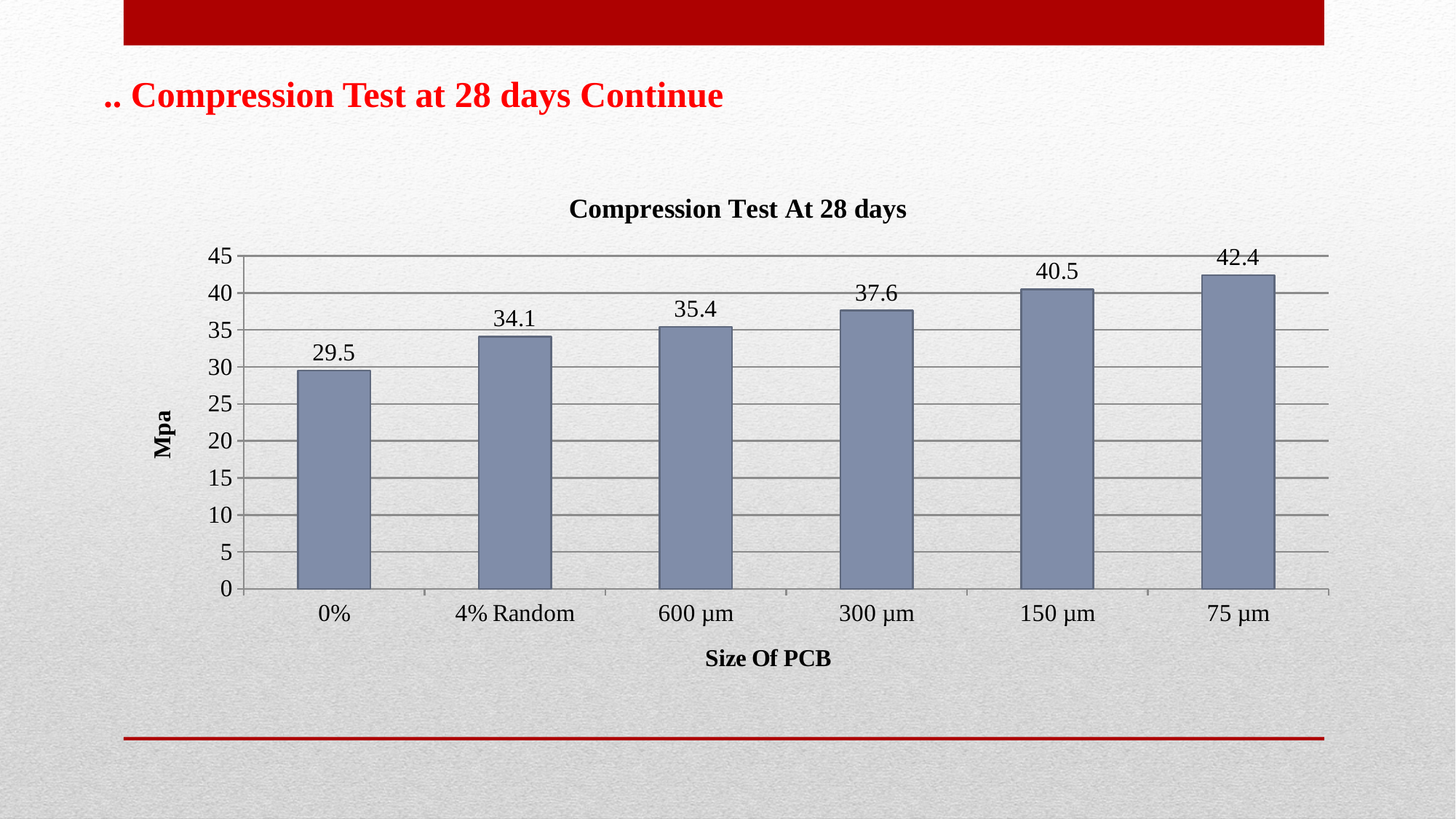
What kind of chart is shown? bar chart What is the value for 300 µm? 37.6 Is the value for 150 µm greater or less than 40? greater Which is larger, the value for 600 µm or the value for 300 µm? 300 µm What is the compression strength value for 0%? 29.5 Which category has the lowest value? 0% What is the difference between the values for 75 µm and 0%? 12.9 Which size of PCB has the highest compression strength? 75 µm How many categories are shown on the x axis? 6 What is the difference between the values for 150 µm and 600 µm? 5.1 What is the value for 4% Random? 34.1 Do the values rise or fall from left to right along the x axis? rise